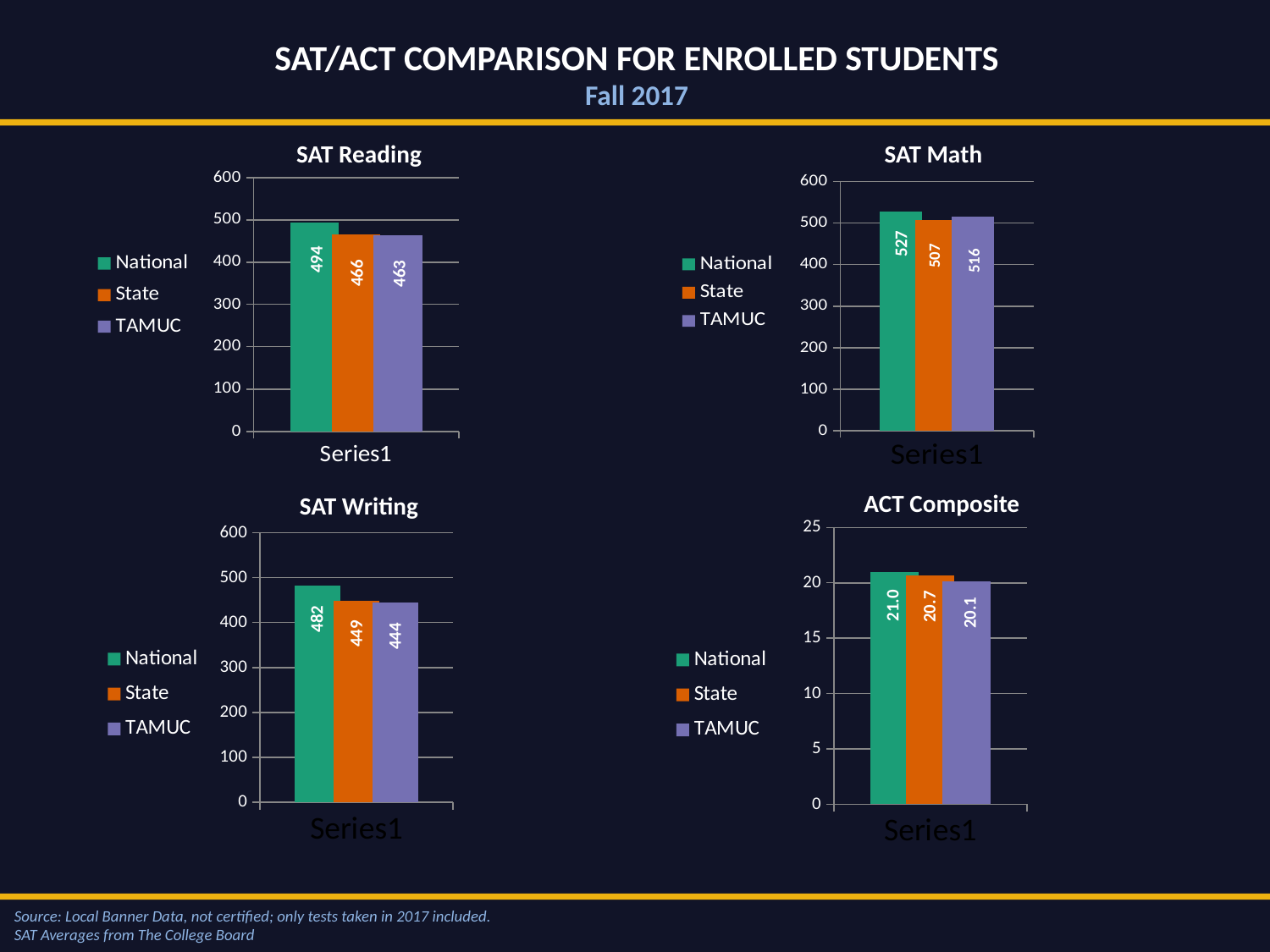
In the SAT Writing chart, which series has the lowest value? TAMUC In the SAT Math chart, which series has the highest value? National In the SAT Math chart, what is the difference between the TAMUC and State values? 9 In the SAT Reading chart, what is the value for National? 494 In the SAT Math chart, which is larger, the State value or the TAMUC value? TAMUC What kind of chart is the SAT Writing chart? Bar chart In the SAT Writing chart, what is the value for State? 449 How many series does the legend of the ACT Composite chart list? 3 In the ACT Composite chart, what is the value for TAMUC? 20.1 In the SAT Reading chart, what is the difference between the National and TAMUC values? 31 In the SAT Reading chart, what colour are the State bars? Orange In the SAT Math chart, what is the value for TAMUC? 516